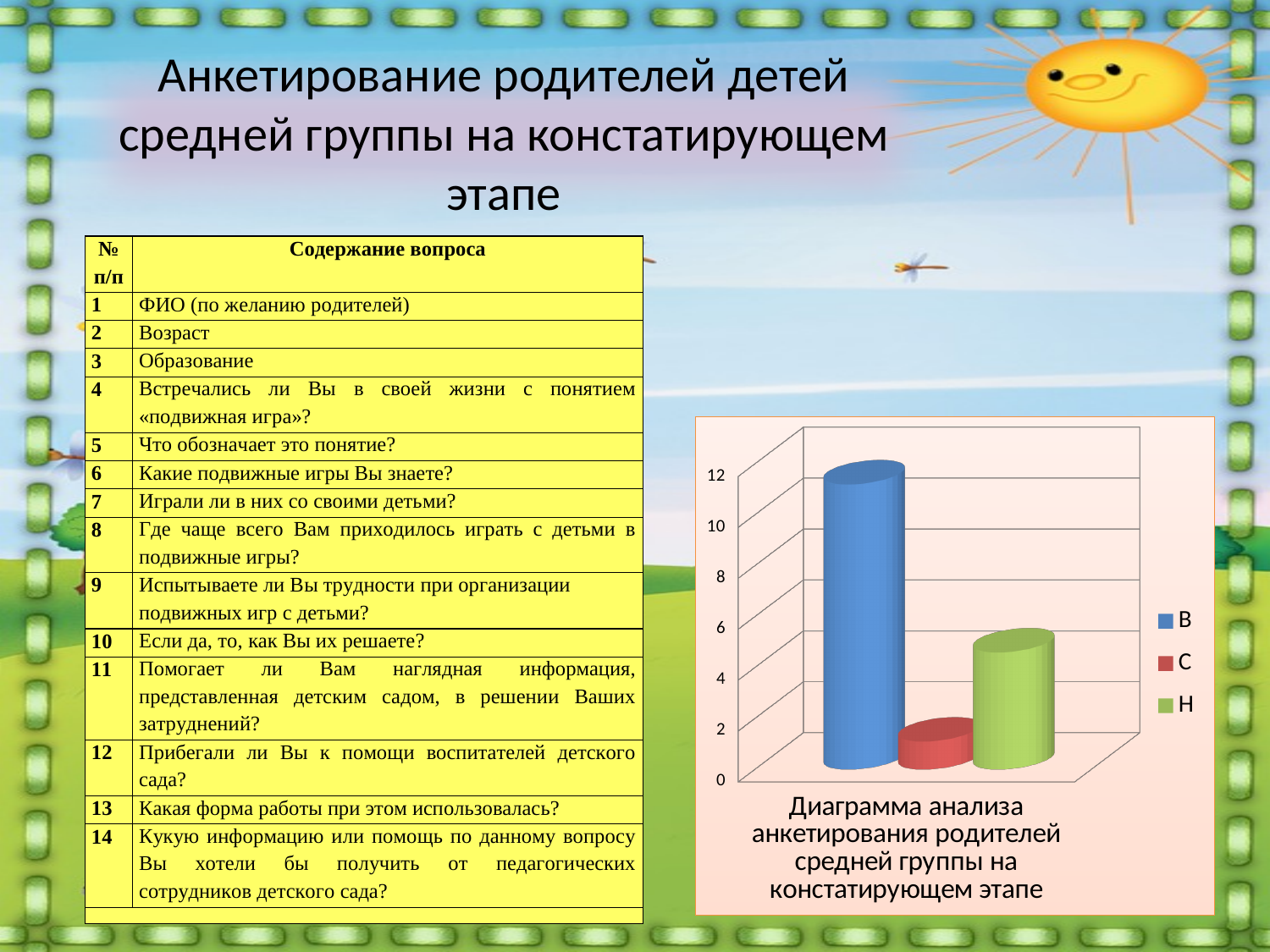
Is the value for Н greater or less than 4? greater What colour is the bar for series С? red Which series has the lowest value in the chart? С What kind of chart is shown on the slide? bar chart What is the caption under the chart? Диаграмма анализа анкетирования родителей средней группы на констатирующем этапе Is the value for С greater or less than 2? less Which series has the highest value in the chart? В Which is larger, the value for С or the value for Н? Н How many series does the chart legend list? 3 Which is larger, the value for В or the value for Н? В Is the value for В greater or less than 10? greater